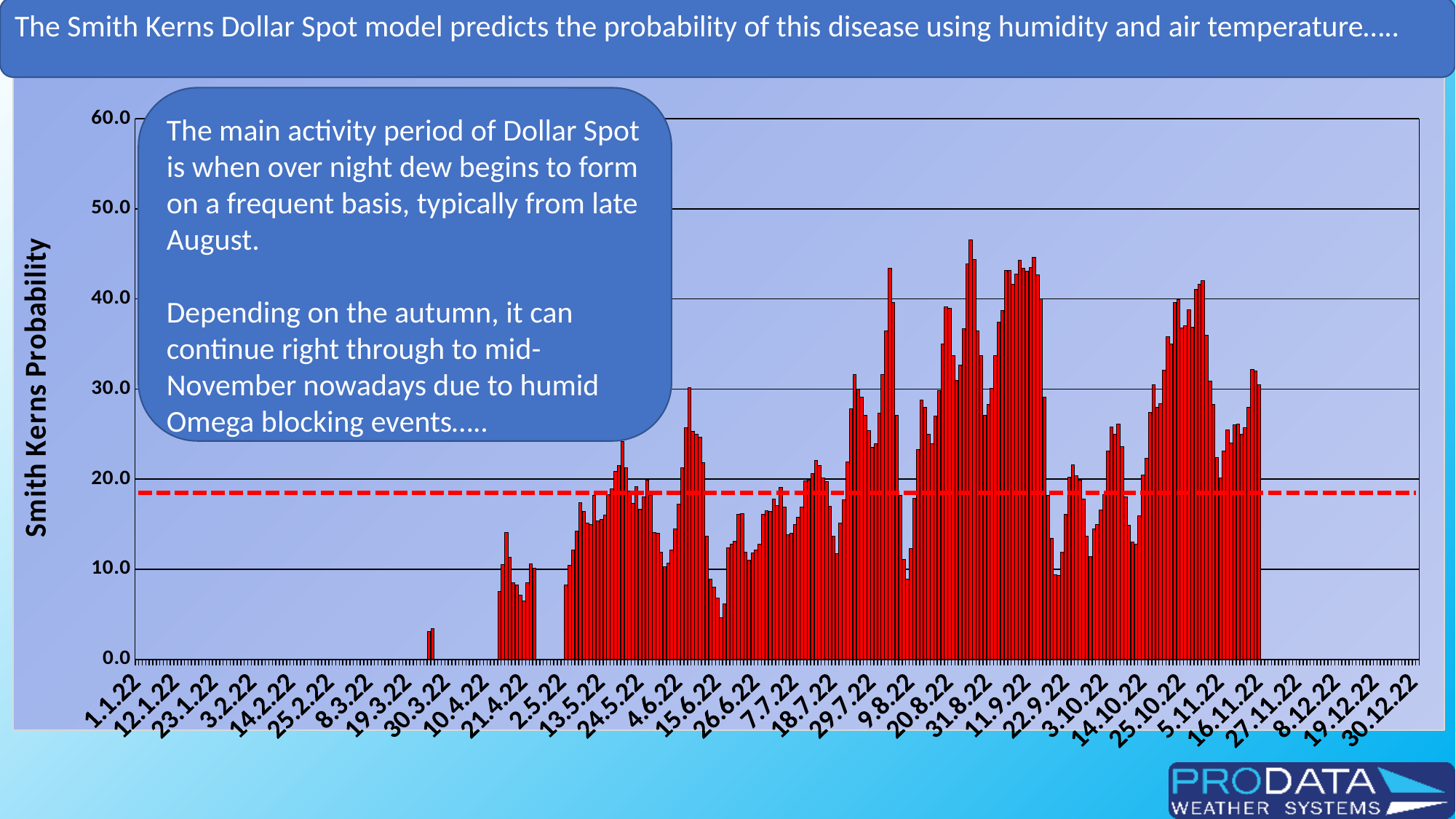
Is the tallest bar in the chart greater or less than 40? greater What is the label on the y axis of the chart? Smith Kerns Probability Which has the larger value, 30.3.22 or 13.5.22? 13.5.22 Is the value for 21.4.22 greater or less than 20? less Is the value for 11.9.22 greater or less than 40? greater How many date labels are shown along the x axis of the chart? 34 What is the highest value shown on the y axis of the chart? 60.0 What kind of chart is shown on the slide? bar chart Which has the larger value, 21.4.22 or 11.9.22? 11.9.22 Do the values generally rise or fall from 1.1.22 to 31.8.22? rise